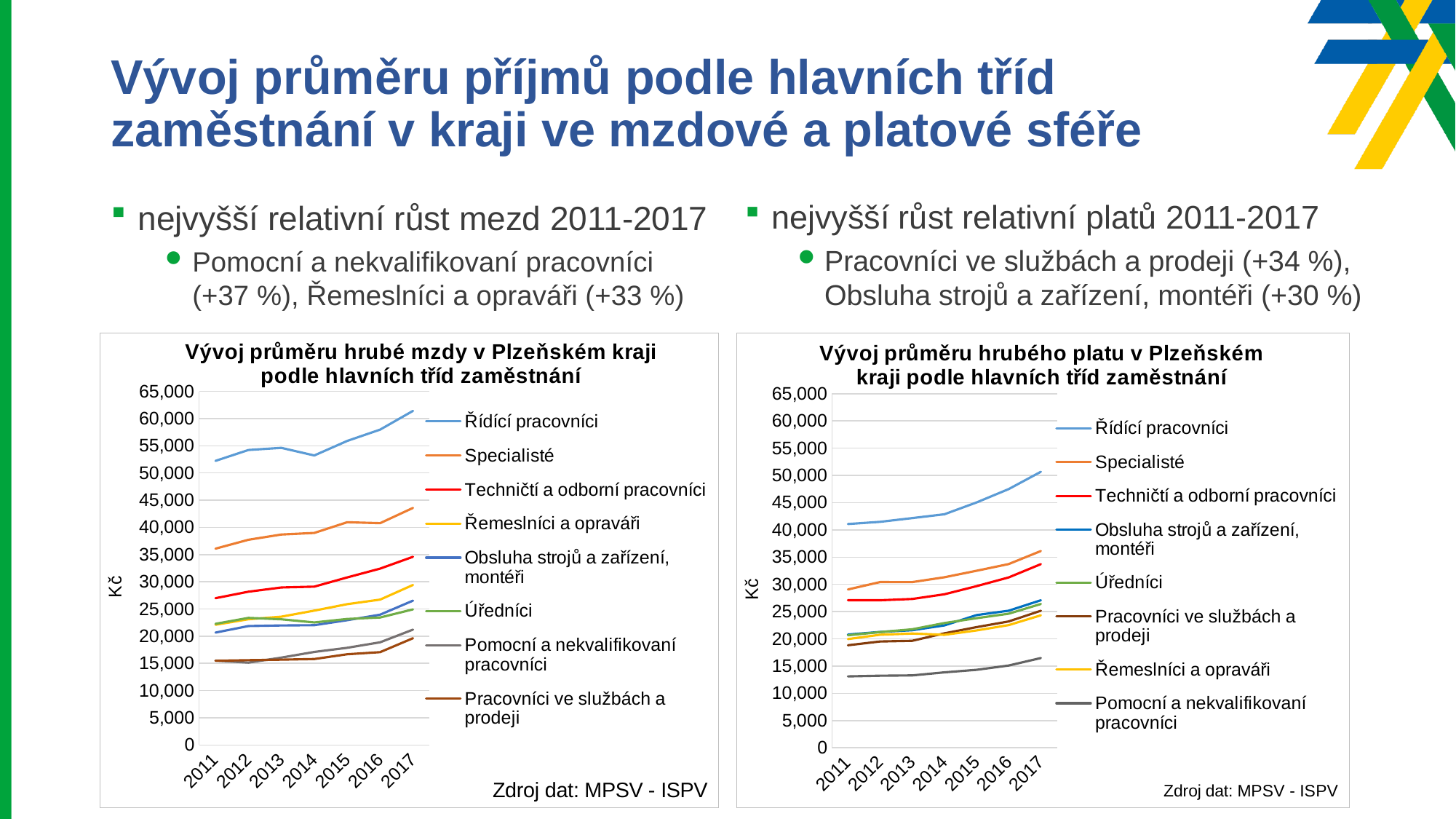
In the right chart, 'Vývoj průměru hrubého platu v Plzeňském kraji podle hlavních tříd zaměstnání', which series has the lowest values throughout the period? Pomocní a nekvalifikovaní pracovníci In the left chart, 'Vývoj průměru hrubé mzdy v Plzeňském kraji podle hlavních tříd zaměstnání', is the value for Řídící pracovníci in 2017 greater or less than 60,000? greater In the left chart, 'Vývoj průměru hrubé mzdy v Plzeňském kraji podle hlavních tříd zaměstnání', which series has the highest values throughout the period? Řídící pracovníci In the right chart, 'Vývoj průměru hrubého platu v Plzeňském kraji podle hlavních tříd zaměstnání', is the value for Řídící pracovníci in 2017 greater or less than 45,000? greater In the right chart, 'Vývoj průměru hrubého platu v Plzeňském kraji podle hlavních tříd zaměstnání', is the value for Pomocní a nekvalifikovaní pracovníci in 2011 greater or less than 15,000? less In the left chart, 'Vývoj průměru hrubé mzdy v Plzeňském kraji podle hlavních tříd zaměstnání', do the values for Specialisté rise or fall from 2011 to 2017? rise Which is larger in 2017: the value for Řídící pracovníci in the left chart (hrubé mzdy) or in the right chart (hrubého platu)? Left chart (hrubé mzdy) What data source is cited below the right chart, 'Vývoj průměru hrubého platu v Plzeňském kraji podle hlavních tříd zaměstnání'? MPSV - ISPV What unit is shown on the y axis of the left chart, 'Vývoj průměru hrubé mzdy v Plzeňském kraji podle hlavních tříd zaměstnání'? Kč How many years are plotted on the x axis of the left chart, 'Vývoj průměru hrubé mzdy v Plzeňském kraji podle hlavních tříd zaměstnání'? 7 What type of chart is the left chart, 'Vývoj průměru hrubé mzdy v Plzeňském kraji podle hlavních tříd zaměstnání'? Line chart How many series does the legend of the right chart, 'Vývoj průměru hrubého platu v Plzeňském kraji podle hlavních tříd zaměstnání', list? 8